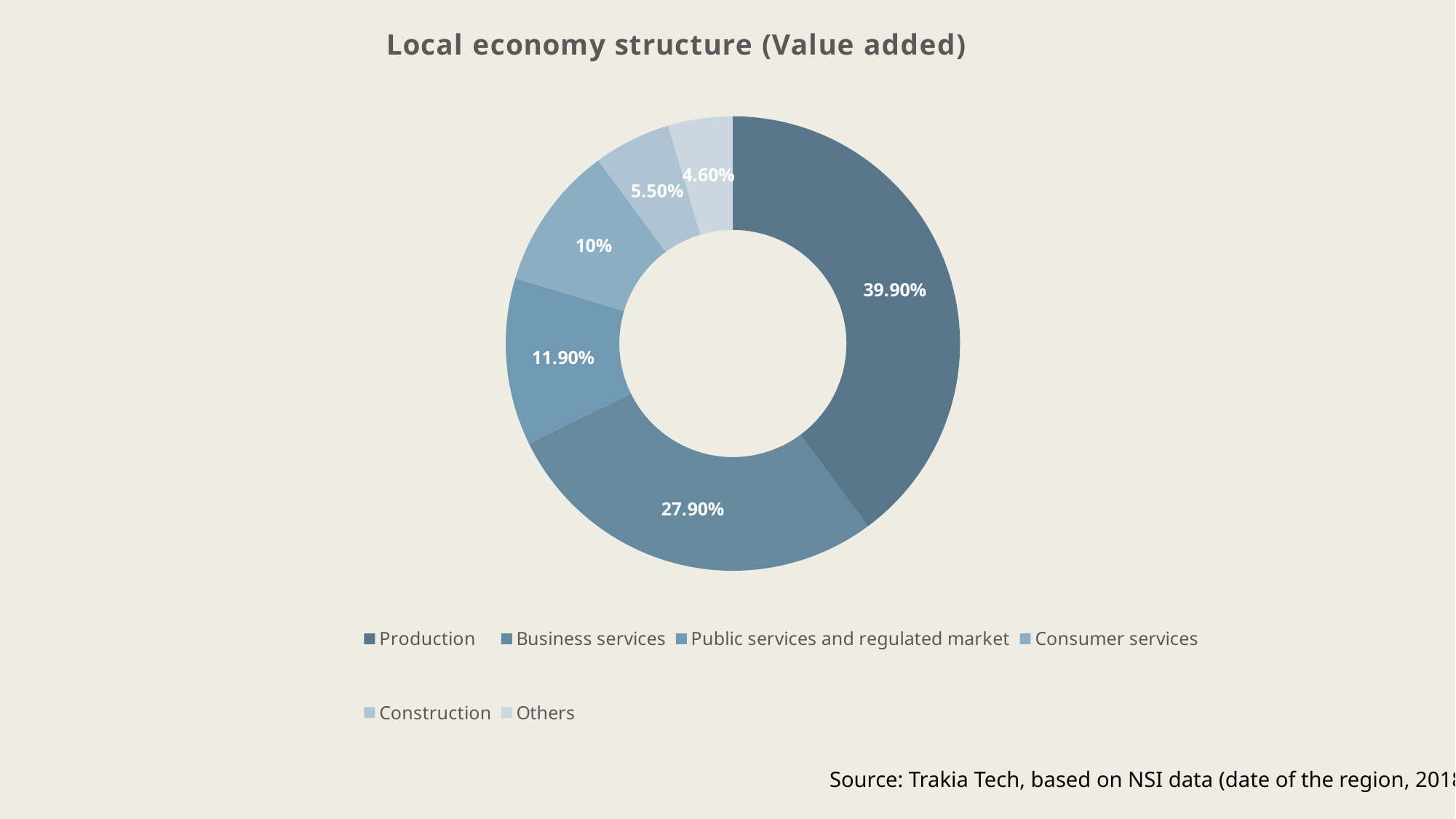
What is the value shown for Public services and regulated market? 11.90% Which is larger, Consumer services or Construction? Consumer services What is the value shown for Business services? 27.90% What is the title of the chart? Local economy structure (Value added) What is the combined share of Construction and Others? 10.10% What is the value shown for Construction? 5.50% What is the difference between the Production and Business services shares? 12.00% What kind of chart is shown on the slide? Doughnut (pie) chart Which category has the largest share of the chart? Production How many categories does the legend list? 6 Which category has the smallest share of the chart? Others What share of value added does Production account for? 39.90%